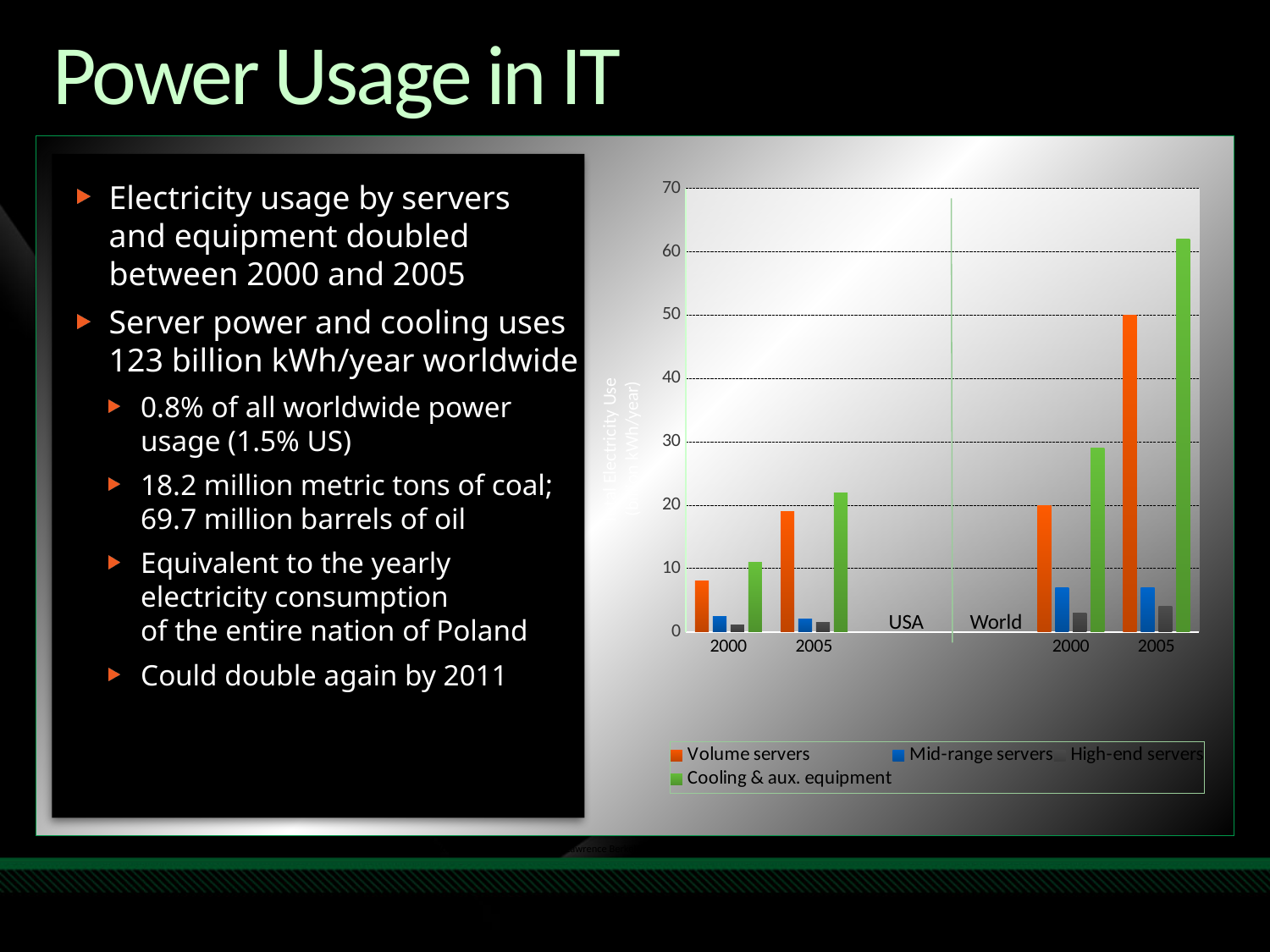
How many year groups of bars are plotted on the chart? 4 Which series has the shortest bar for USA in 2000? High-end servers What kind of chart is shown on the slide? bar chart Which is larger for Volume servers in the USA: the 2000 value or the 2005 value? 2005 For World in 2005, which is larger: Volume servers or Cooling & aux. equipment? Cooling & aux. equipment Is the value for Volume servers for World in 2000 greater or less than 30? less Is the value for Volume servers for USA in 2000 greater or less than 10? less Do the Cooling & aux. equipment values rise or fall from 2000 to 2005 for the World? rise Is the value for Cooling & aux. equipment for World in 2005 greater or less than 50? greater What colour are the Volume servers bars? orange How many series does the chart legend list? 4 Which series has the tallest bar for World in 2005? Cooling & aux. equipment